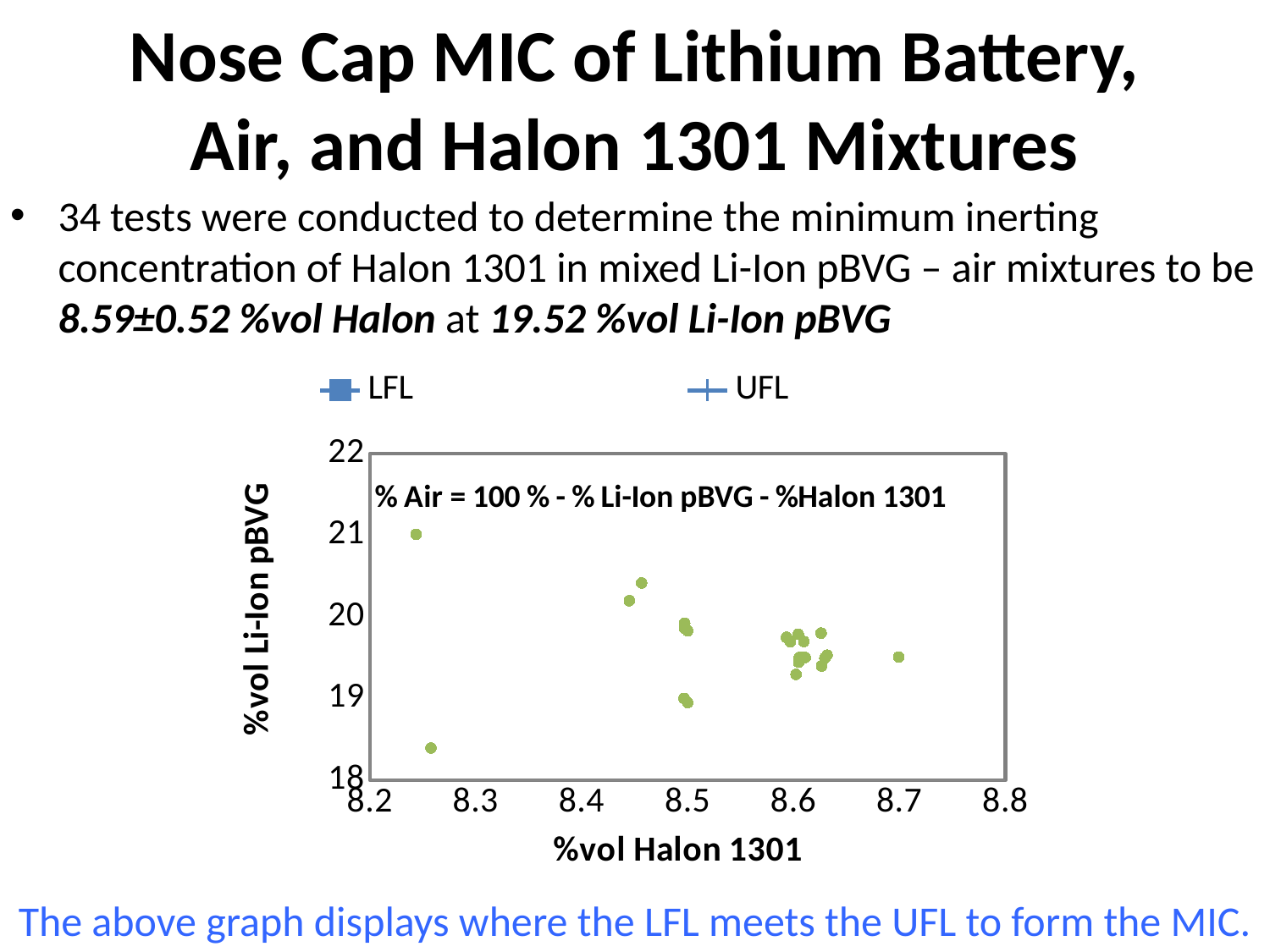
Are the %vol Halon 1301 values of all plotted points greater or less than 8.8? less What are the two series named in the chart legend? LFL and UFL Is the %vol Li-Ion pBVG of the rightmost plotted point greater or less than 20? less Is the %vol Halon 1301 of the rightmost plotted point greater or less than 8.6? greater What kind of chart is shown on the slide? scatter chart How many series does the chart legend list? 2 What is the title of the chart's x axis? %vol Halon 1301 Which plotted point has the higher %vol Li-Ion pBVG: the point near 8.25 %vol Halon 1301 at the top of the chart or the point near 8.7 %vol Halon 1301? the point near 8.25 %vol Halon 1301